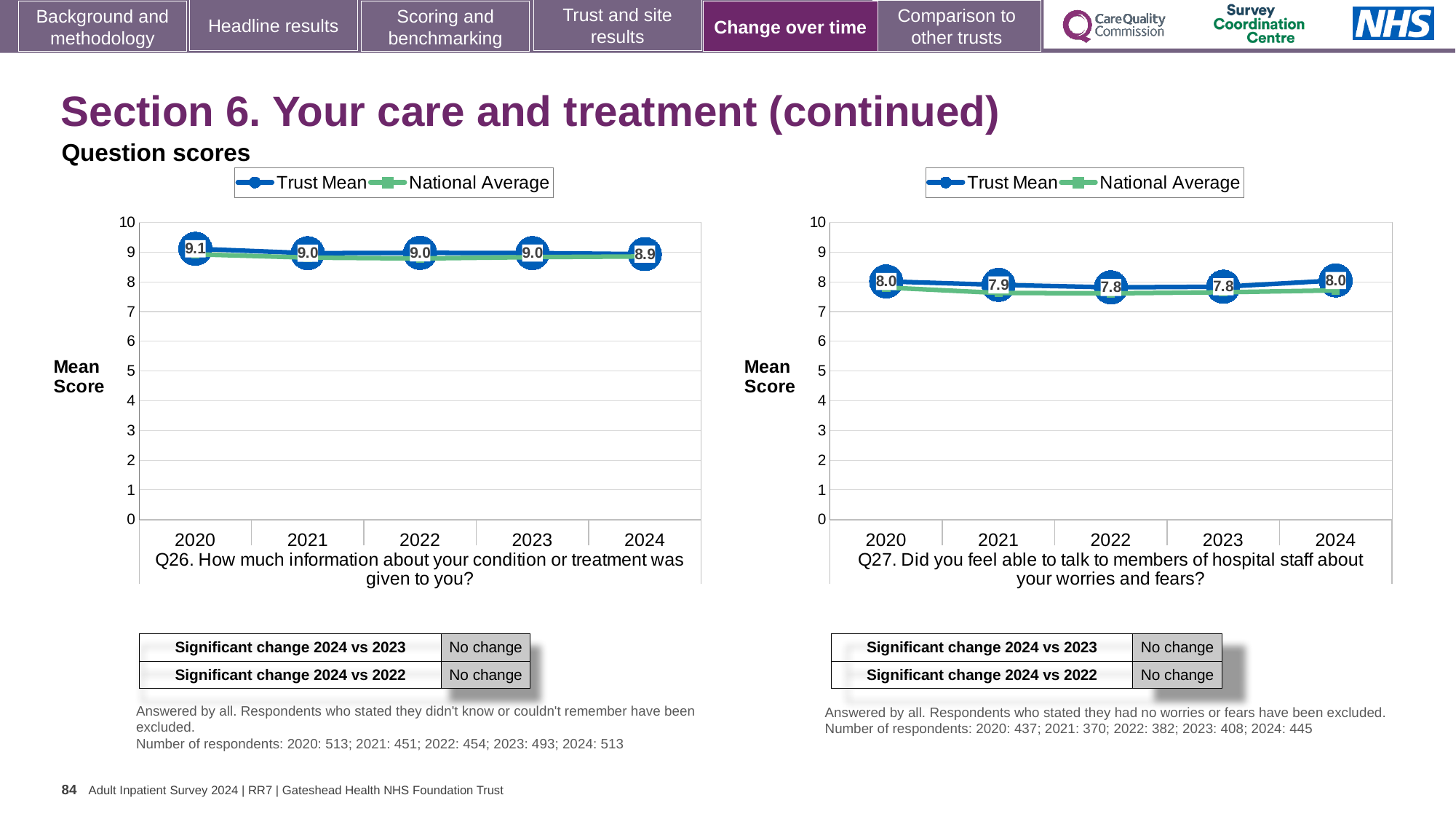
In the Q26 chart on the left, what is the difference between the Trust Mean scores for 2020 and 2024? 0.2 In the Q26 chart on the left, which year has the lowest Trust Mean score? 2024 How many series does the legend of the Q27 chart on the right list? 2 What kind of chart is the Q26 chart on the left? Line chart In the Q26 chart on the left, what is the Trust Mean score for 2024? 8.9 In the Q27 chart on the right, what is the Trust Mean score for 2024? 8.0 How many years are plotted on the x axis of the Q26 chart on the left? 5 In the Q26 chart on the left, which year has the highest Trust Mean score? 2020 In the Q27 chart on the right, which is larger, the Trust Mean score for 2020 or for 2022? 2020 In the Q26 chart on the left, what is the Trust Mean score for 2020? 9.1 In the Q27 chart on the right, is the National Average value for 2021 greater or less than 8? less In the Q27 chart on the right, what is the Trust Mean score for 2021? 7.9